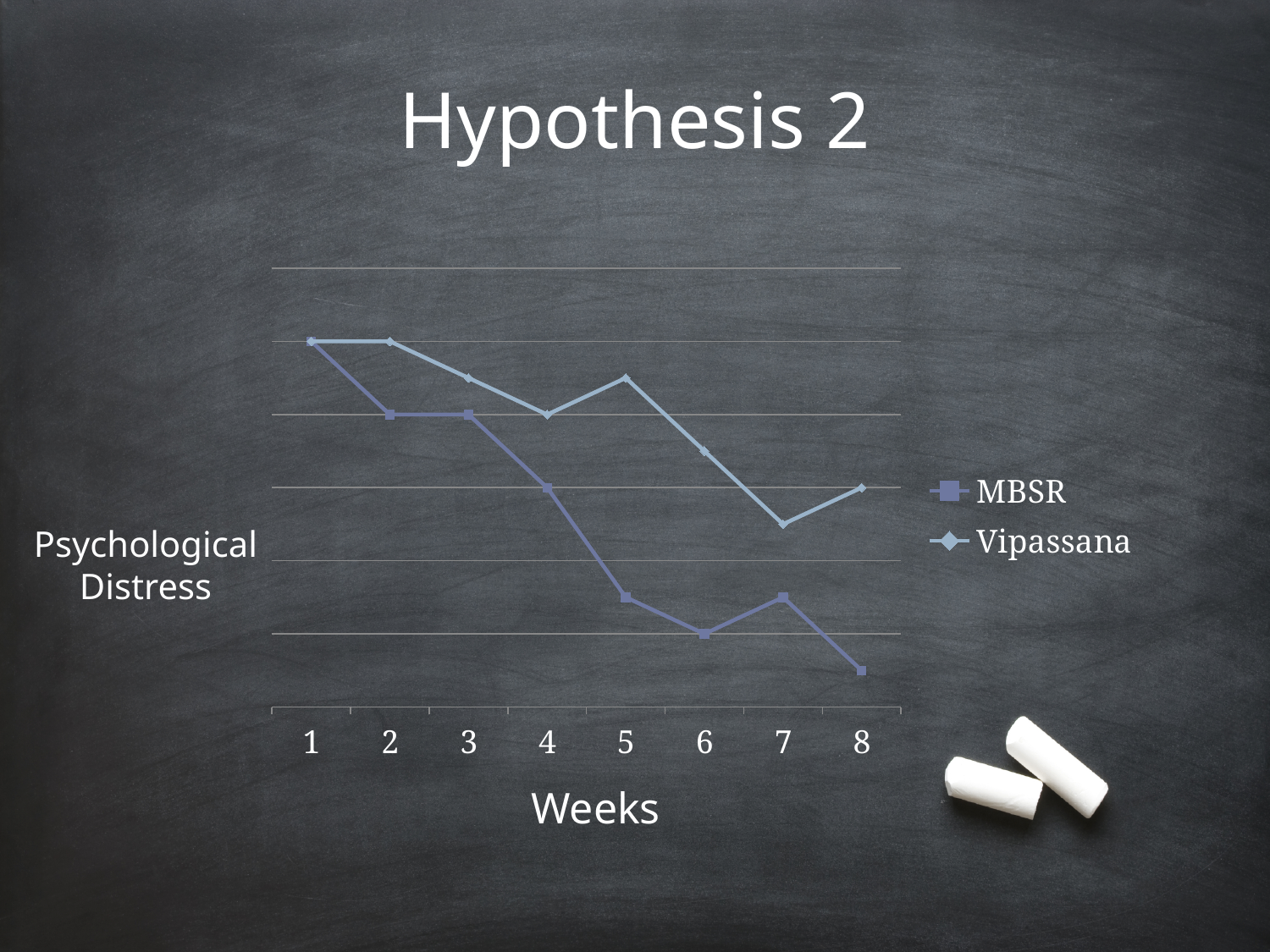
How many weeks are plotted along the x axis? 8 How many series does the legend list? 2 In which week does the MBSR series reach its lowest value? 8 At week 5, which series has the higher value, MBSR or Vipassana? Vipassana What kind of chart is shown on the slide? line chart In which week does the Vipassana series reach its lowest value? 7 Does the MBSR series generally rise or fall from week 1 to week 8? fall What is the label on the y axis of the chart? Psychological Distress For the Vipassana series, is the value at week 5 higher or lower than at week 4? higher What is the label on the x axis of the chart? Weeks Does the Vipassana series generally rise or fall from week 1 to week 8? fall At week 8, which series has the lower value, MBSR or Vipassana? MBSR